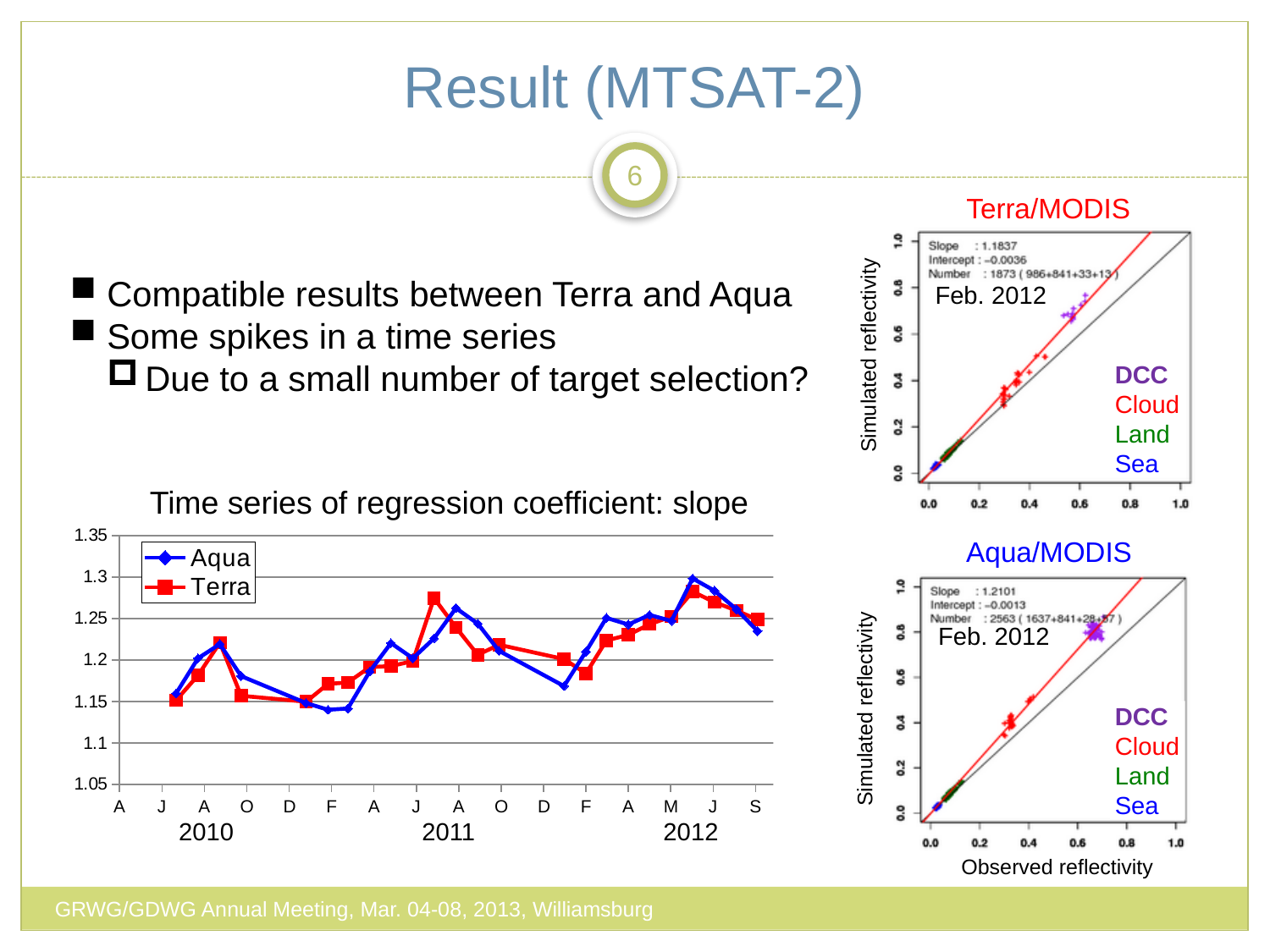
What are the two series named in the legend of the 'Time series of regression coefficient: slope' chart? Aqua and Terra In the Terra/MODIS scatter plot, what is the printed slope? 1.1837 In the Aqua/MODIS scatter plot, what is the printed slope? 1.2101 In the 'Time series of regression coefficient: slope' chart, do the slope values overall rise or fall from 2010 to 2012? rise In the 'Time series of regression coefficient: slope' chart, which series has the higher value at February 2011, Aqua or Terra? Terra How many series does the legend of the 'Time series of regression coefficient: slope' chart list? 2 In the 'Time series of regression coefficient: slope' chart, is the first Aqua value in 2010 greater or less than 1.2? less Which scatter plot has the larger printed slope, Terra/MODIS or Aqua/MODIS? Aqua/MODIS In the Terra/MODIS scatter plot, what is the printed intercept? -0.0036 In the Aqua/MODIS scatter plot, what is the printed Number of points? 2563 In the 'Time series of regression coefficient: slope' chart, is the Terra peak around July 2011 greater or less than 1.25? greater What kind of chart is the 'Time series of regression coefficient: slope' chart? line chart